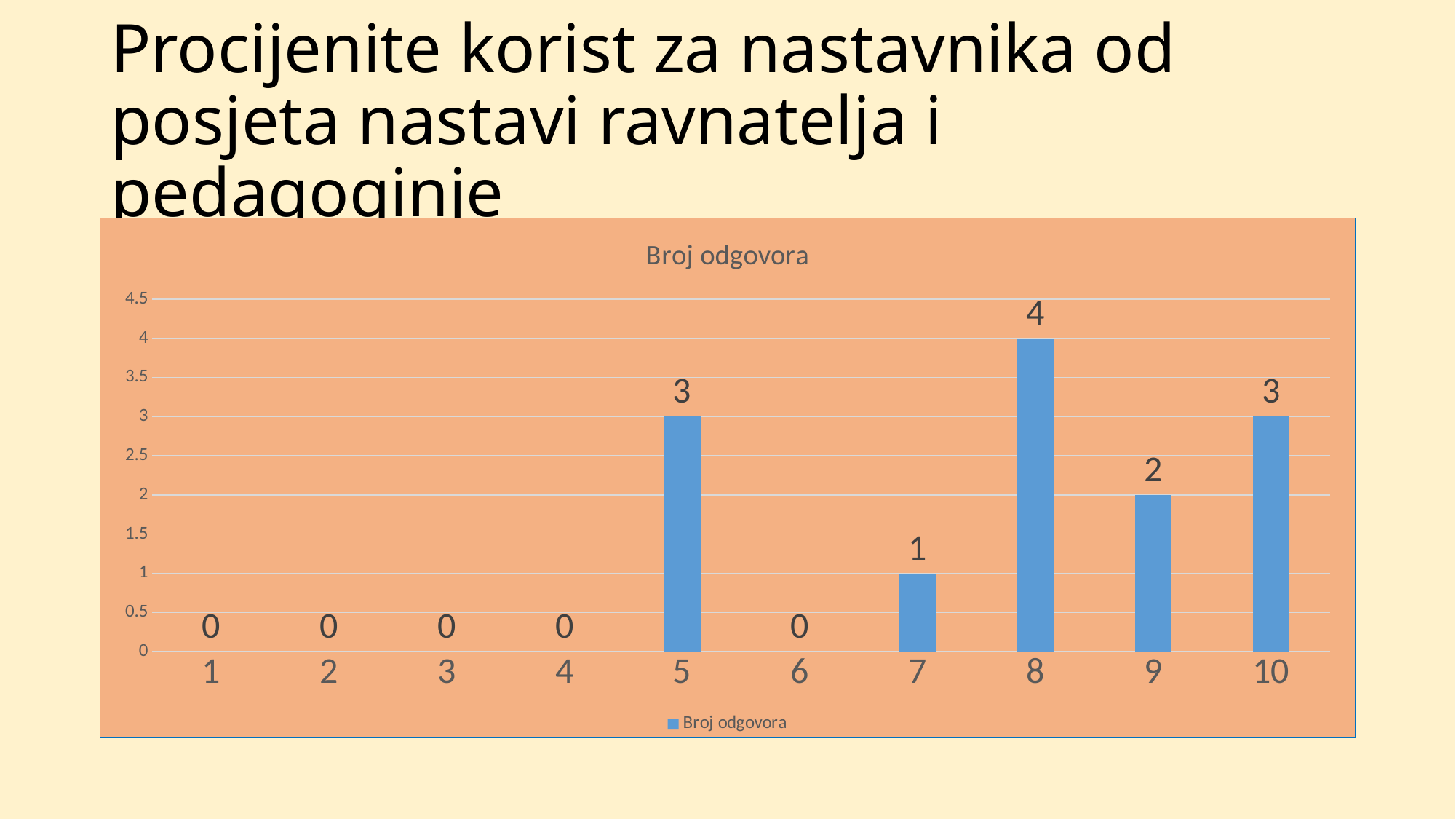
What is the difference between the values for category 8 and category 9? 2 What is the value for category 8? 4 What is the value for category 7? 1 What is the value for category 5? 3 What is the title of the chart? Broj odgovora How many categories have a value of 0? 5 Which category has the highest value? 8 What kind of chart is shown? bar chart What is the value for category 9? 2 How many series does the legend list? 1 Which is larger, the value for category 7 or the value for category 10? category 10 How many categories are shown on the x axis? 10